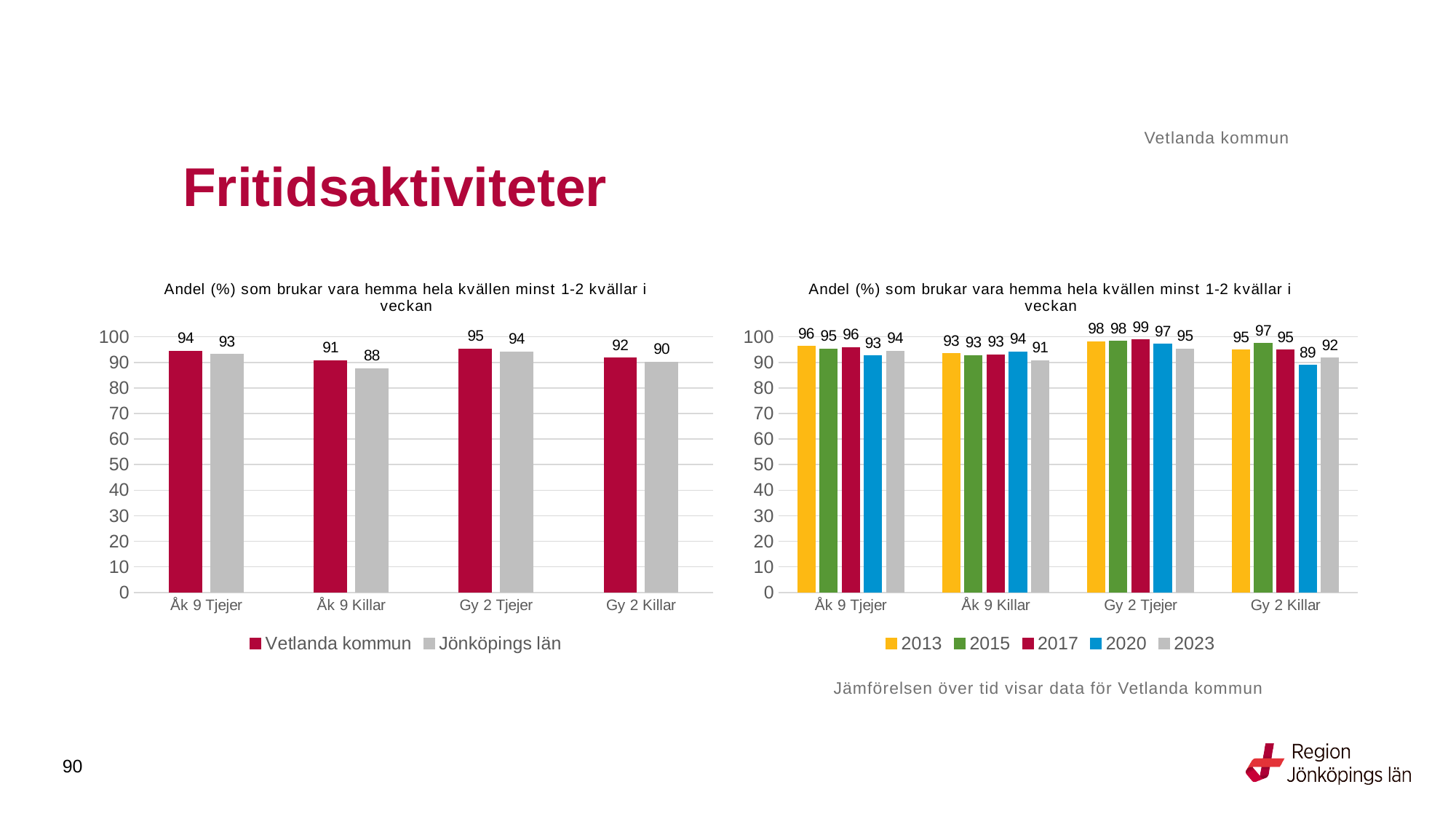
In the right chart, how many series does the legend list? 5 In the right chart, which year has the highest value for Gy 2 Killar? 2015 In the right chart, what is the difference between the 2015 and 2020 values for Gy 2 Killar? 8 In the left chart, how many series does the legend list? 2 In the left chart, what is the value for Vetlanda kommun for Åk 9 Killar? 91 In the right chart, what is the value for 2020 for Gy 2 Killar? 89 In the right chart, how many categories are shown on the x axis? 4 In the left chart, what is the difference between Vetlanda kommun and Jönköpings län for Åk 9 Killar? 3 In the left chart, what is the value for Jönköpings län for Gy 2 Killar? 90 In the right chart, what is the value for 2017 for Gy 2 Tjejer? 99 In the left chart, which category has the lowest value for Jönköpings län? Åk 9 Killar What kind of chart is the left chart? Bar chart